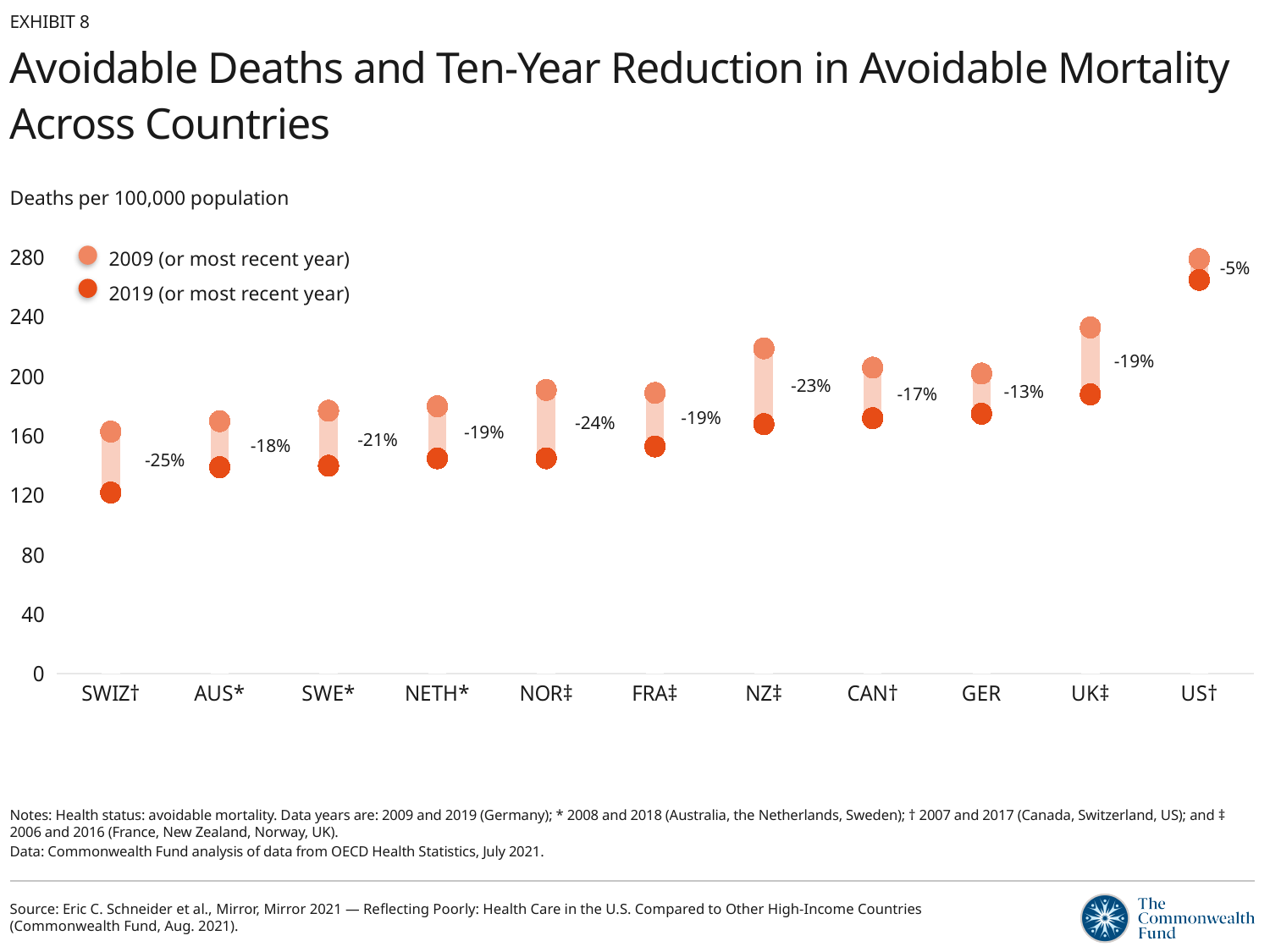
What percentage reduction is labeled for GER? -13% How many countries are shown on the x axis? 11 Is the 2019 (or most recent year) value for SWIZ† greater or less than 160 deaths per 100,000? less What percentage reduction is labeled for US†? -5% Which country shows the largest percentage reduction in avoidable mortality? SWIZ† What is the ten-year reduction in avoidable mortality shown for SWIZ†? -25% How many percentage points larger is the reduction for SWIZ† (-25%) than for US† (-5%)? 20 percentage points How many series does the legend list? 2 Which has the higher 2019 (or most recent year) value, US† or SWIZ†? US† Which country shows the smallest percentage reduction in avoidable mortality? US† Is the 2019 (or most recent year) value for US† greater or less than 240 deaths per 100,000? greater What percentage reduction is labeled for NOR‡? -24%